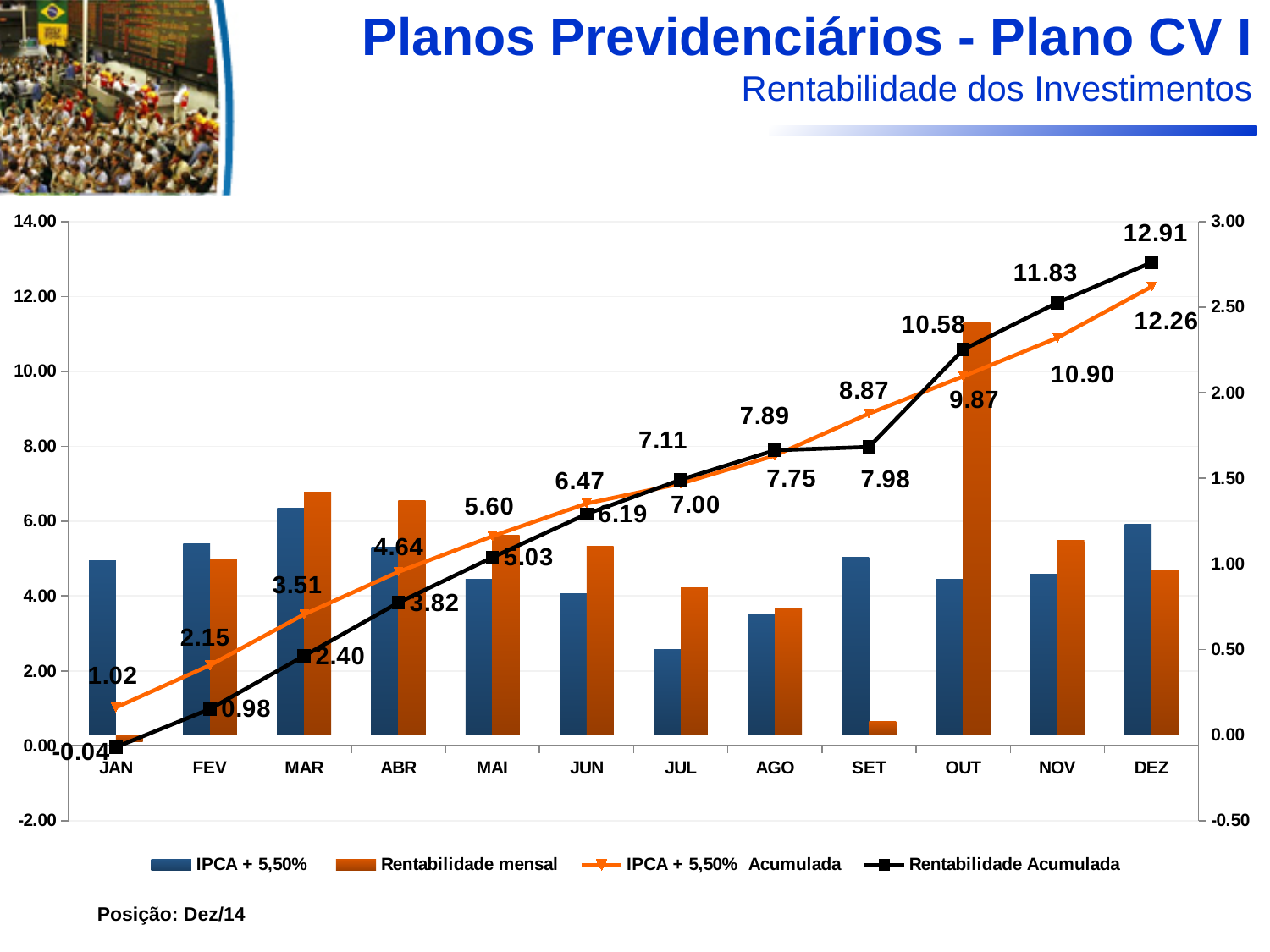
Does Rentabilidade Acumulada rise or fall from JAN to DEZ? rise How many months are shown on the x axis? 12 What is the value of Rentabilidade Acumulada in DEZ? 12.91 Is the IPCA + 5,50% bar for JUL greater or less than 4.00 on the left axis? less Is the Rentabilidade mensal bar for OUT greater or less than 10.00 on the left axis? greater In which month is Rentabilidade Acumulada highest? DEZ In which month is IPCA + 5,50% Acumulada lowest? JAN What is the value of Rentabilidade Acumulada in JAN? -0.04 How many series does the legend list? 4 What is the value of IPCA + 5,50% Acumulada in JUN? 6.47 In SET, which is larger: IPCA + 5,50% Acumulada or Rentabilidade Acumulada? IPCA + 5,50% Acumulada What is the difference between Rentabilidade Acumulada and IPCA + 5,50% Acumulada in DEZ? 0.65